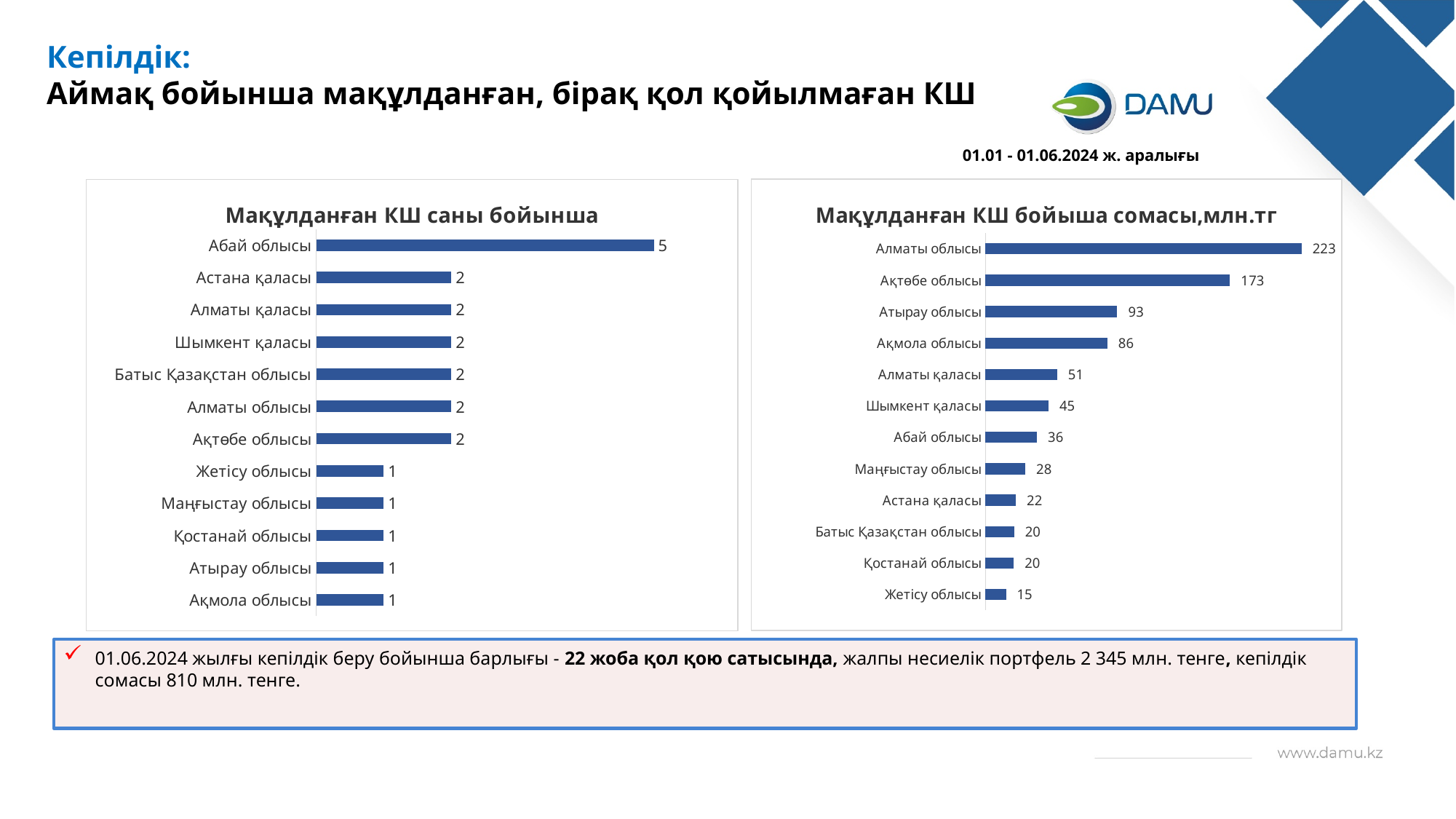
What is the title of the chart on the left side of the slide? Мақұлданған КШ саны бойынша In the chart 'Мақұлданған КШ бойыша сомасы,млн.тг', which is larger: Атырау облысы or Ақмола облысы? Атырау облысы In the chart 'Мақұлданған КШ саны бойынша', which category has the highest value? Абай облысы In the chart 'Мақұлданған КШ бойыша сомасы,млн.тг', what is the difference between Алматы облысы and Ақтөбе облысы? 50 In the chart 'Мақұлданған КШ саны бойынша', what is the value for Абай облысы? 5 In the chart 'Мақұлданған КШ саны бойынша', how many categories are shown? 12 In the chart 'Мақұлданған КШ бойыша сомасы,млн.тг', which category has the lowest value? Жетісу облысы In the chart 'Мақұлданған КШ бойыша сомасы,млн.тг', what is the value for Шымкент қаласы? 45 What type of chart is 'Мақұлданған КШ бойыша сомасы,млн.тг'? Bar chart In the chart 'Мақұлданған КШ саны бойынша', what is the difference between Абай облысы and Астана қаласы? 3 In the chart 'Мақұлданған КШ бойыша сомасы,млн.тг', which category has the highest value? Алматы облысы In the chart 'Мақұлданған КШ бойыша сомасы,млн.тг', what is the value for Ақтөбе облысы? 173